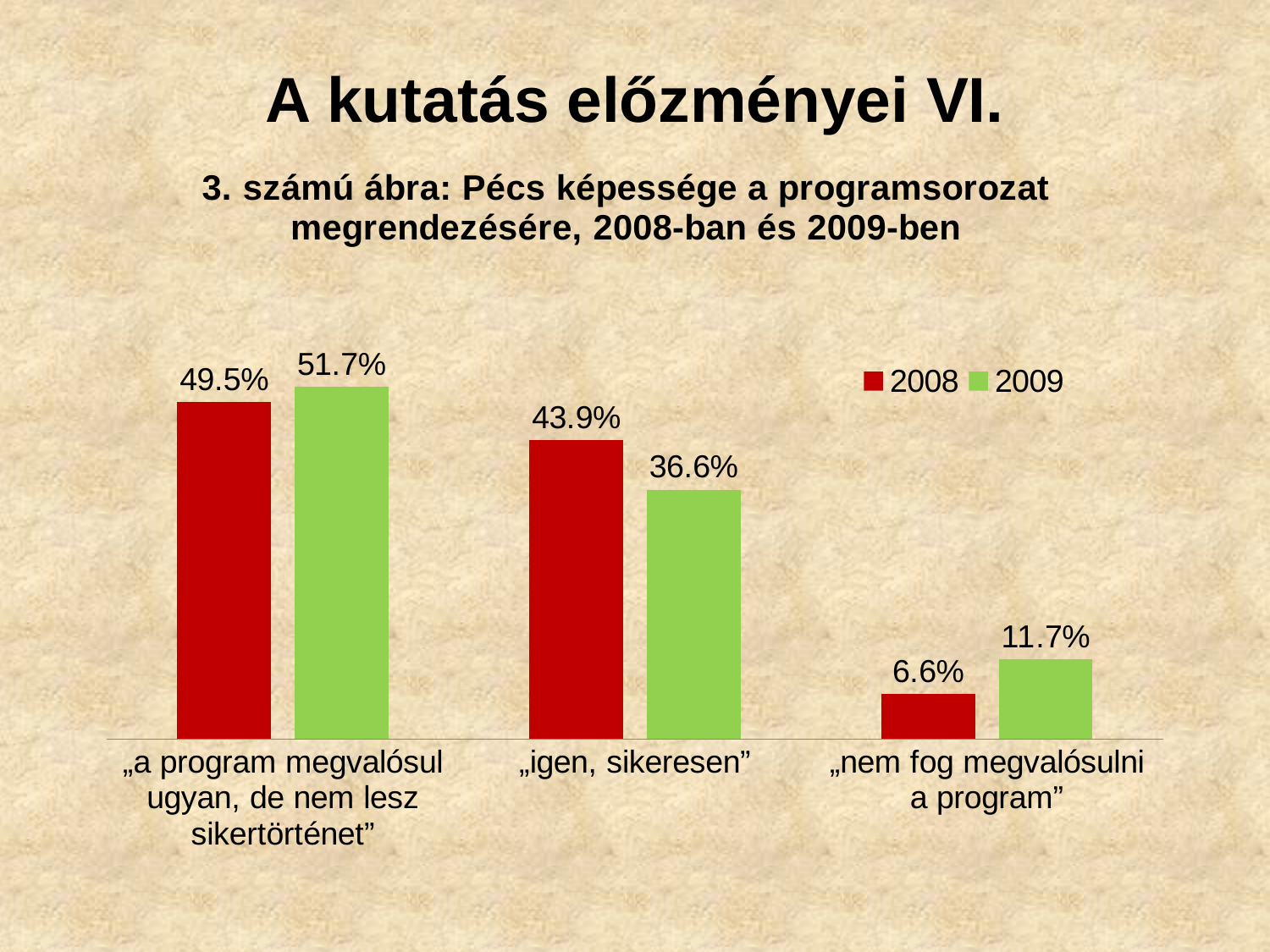
What is the 2008 value for "igen, sikeresen"? 43.9% Which is larger for "nem fog megvalósulni a program": the 2008 value or the 2009 value? 2009 What is the 2008 value for "nem fog megvalósulni a program"? 6.6% Which colour represents the 2008 series? red How many categories are shown on the x axis? 3 What is the 2009 value for "nem fog megvalósulni a program"? 11.7% Which category has the lowest 2008 value? "nem fog megvalósulni a program" What is the 2009 value for "a program megvalósul ugyan, de nem lesz sikertörténet"? 51.7% Which category has the highest 2009 value? "a program megvalósul ugyan, de nem lesz sikertörténet" What kind of chart is shown on the slide? bar chart How many series does the legend list? 2 What is the difference between the 2008 and 2009 values for "igen, sikeresen"? 7.3%